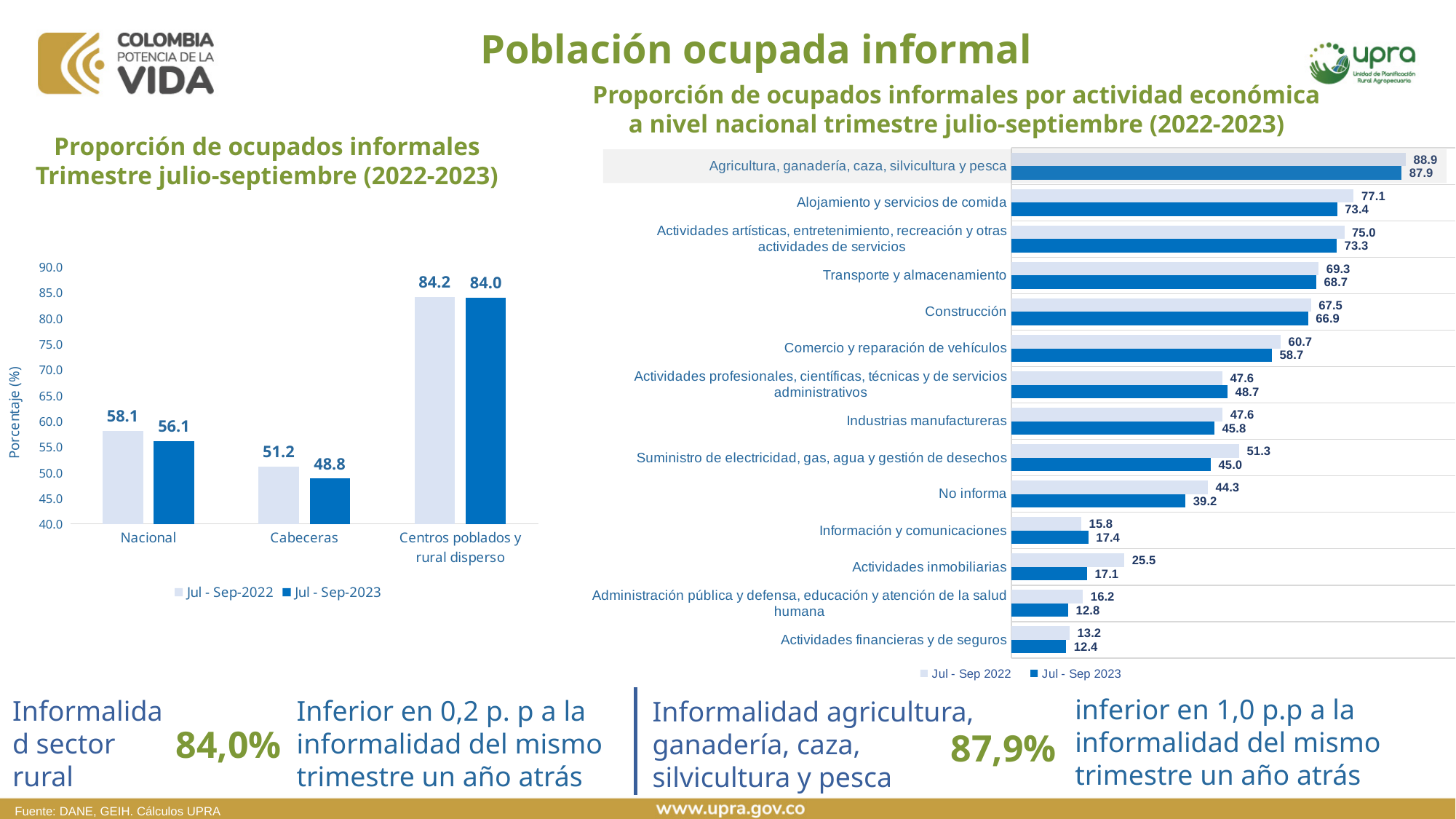
In the left chart (Proporción de ocupados informales, Trimestre julio-septiembre), what kind of chart is it? Bar chart In the left chart (Proporción de ocupados informales, Trimestre julio-septiembre), what is the value for Nacional in Jul - Sep-2023? 56.1 In the right chart (Proporción de ocupados informales por actividad económica), what is the Jul - Sep 2023 value for Construcción? 66.9 In the left chart (Proporción de ocupados informales, Trimestre julio-septiembre), which category has the highest value in Jul - Sep-2023? Centros poblados y rural disperso In the right chart (Proporción de ocupados informales por actividad económica), which activity has the lowest Jul - Sep 2023 value? Actividades financieras y de seguros In the left chart (Proporción de ocupados informales, Trimestre julio-septiembre), how many series does the legend list? 2 In the right chart (Proporción de ocupados informales por actividad económica), what is the Jul - Sep 2022 value for Actividades inmobiliarias? 25.5 In the right chart (Proporción de ocupados informales por actividad económica), which is larger for Información y comunicaciones: the Jul - Sep 2022 value or the Jul - Sep 2023 value? Jul - Sep 2023 In the right chart (Proporción de ocupados informales por actividad económica), how many economic activities are listed? 14 In the left chart (Proporción de ocupados informales, Trimestre julio-septiembre), what is the difference between the Jul - Sep-2022 and Jul - Sep-2023 values for Nacional? 2.0 In the right chart (Proporción de ocupados informales por actividad económica), what is the difference between the Jul - Sep 2022 and Jul - Sep 2023 values for Alojamiento y servicios de comida? 3.7 In the left chart (Proporción de ocupados informales, Trimestre julio-septiembre), what is the value for Cabeceras in Jul - Sep-2022? 51.2